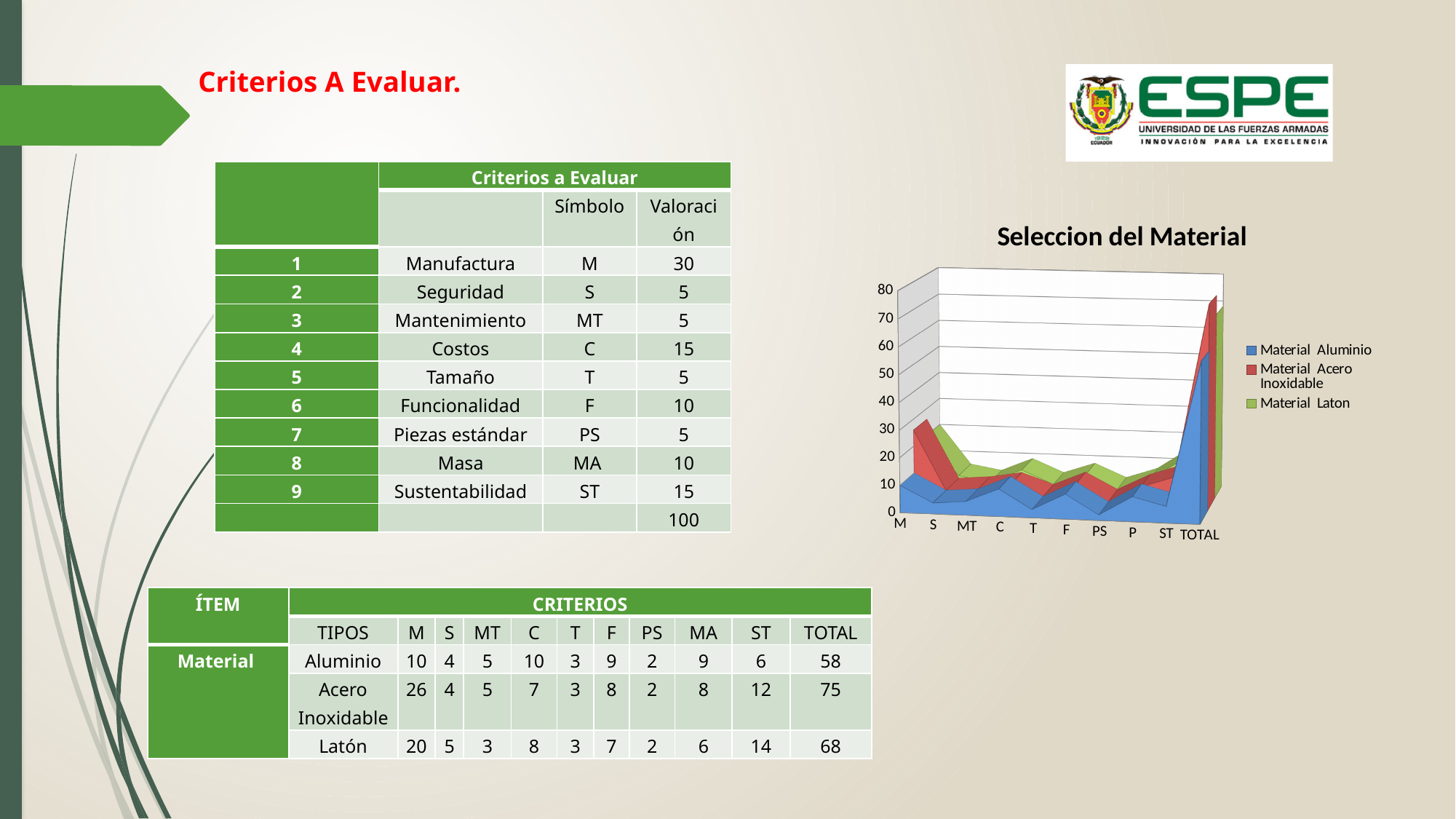
In the 'Seleccion del Material' chart, is the value for Material Aluminio at PS greater or less than 10? less In the 'Seleccion del Material' chart, is the TOTAL value for Material Aluminio greater or less than 40? greater In the 'Seleccion del Material' chart, which series has the larger TOTAL value: Material Aluminio or Material Acero Inoxidable? Material Acero Inoxidable In the 'Seleccion del Material' chart, which category has the highest value for Material Acero Inoxidable? TOTAL In the 'Seleccion del Material' chart, which category has the highest value for Material Aluminio? TOTAL How many series does the legend of the 'Seleccion del Material' chart list? 3 In the 'Seleccion del Material' chart, is the TOTAL value for Material Acero Inoxidable greater or less than 60? greater What kind of chart is 'Seleccion del Material'? area chart What is the title of the chart on the slide? Seleccion del Material Which series in the 'Seleccion del Material' chart is shown in red? Material Acero Inoxidable What is the highest value shown on the vertical axis of the 'Seleccion del Material' chart? 80 How many categories are shown along the x axis of the 'Seleccion del Material' chart? 10